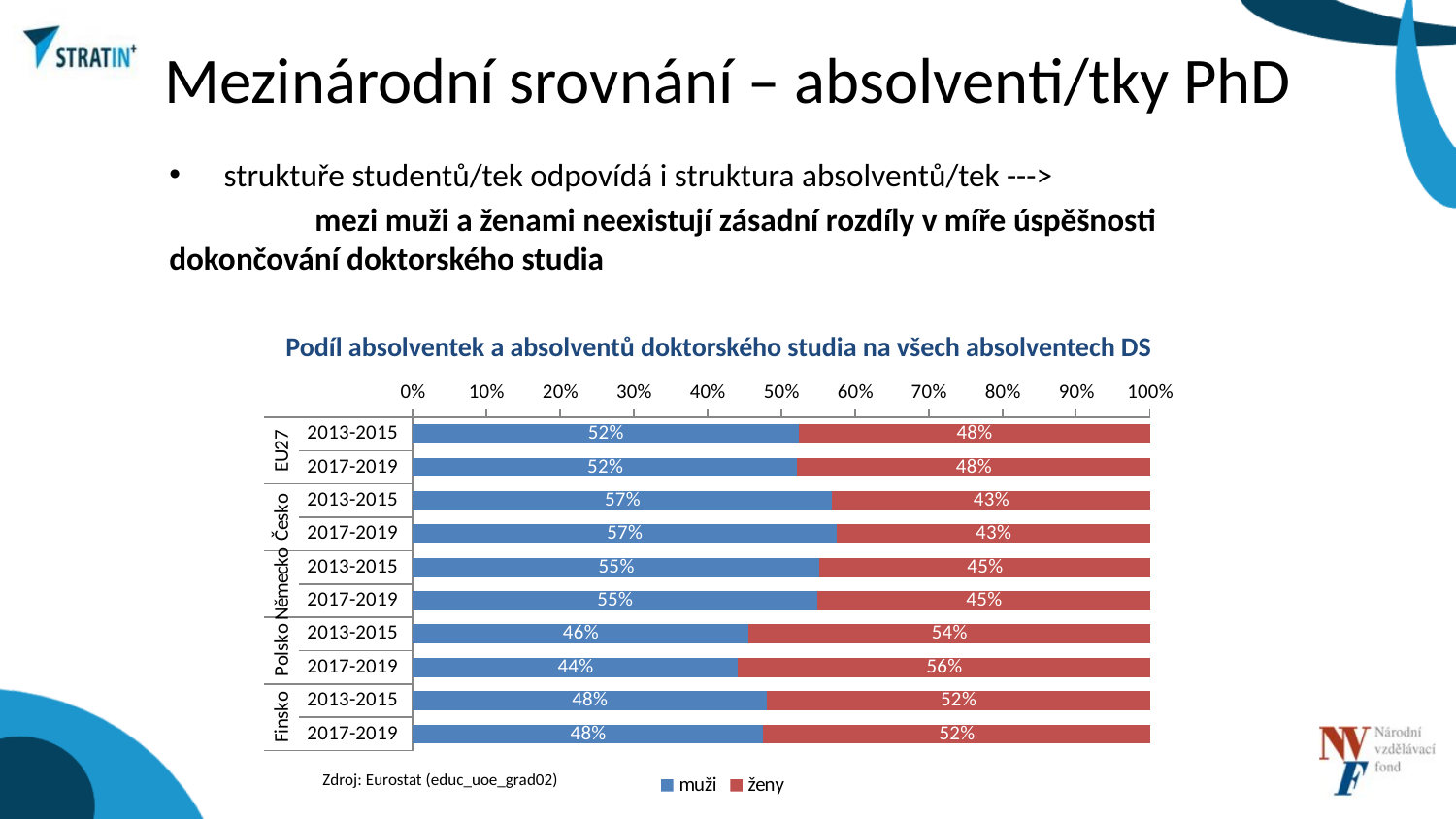
What is the share of muži (men) among PhD graduates in Česko in 2017-2019? 57% What is the title of the chart? Podíl absolventek a absolventů doktorského studia na všech absolventech DS What is the share of muži (men) among PhD graduates in EU27 in 2013-2015? 52% Is the share of muži (men) larger in Česko 2013-2015 or in Polsko 2013-2015? Česko 2013-2015 Which country and period has the lowest share of muži (men) among PhD graduates? Polsko 2017-2019 What is the share of ženy (women) among PhD graduates in Finsko in 2013-2015? 52% Which country and period has the highest share of muži (men) among PhD graduates? Česko, 57% (both 2013-2015 and 2017-2019) How many series does the chart legend list? 2 What type of chart is shown on the slide? stacked bar chart What is the difference between the share of muži and ženy among PhD graduates in Německo in 2013-2015? 10 percentage points How many bars (country-period rows) are shown in the chart? 10 What is the share of ženy (women) among PhD graduates in Polsko in 2017-2019? 56%